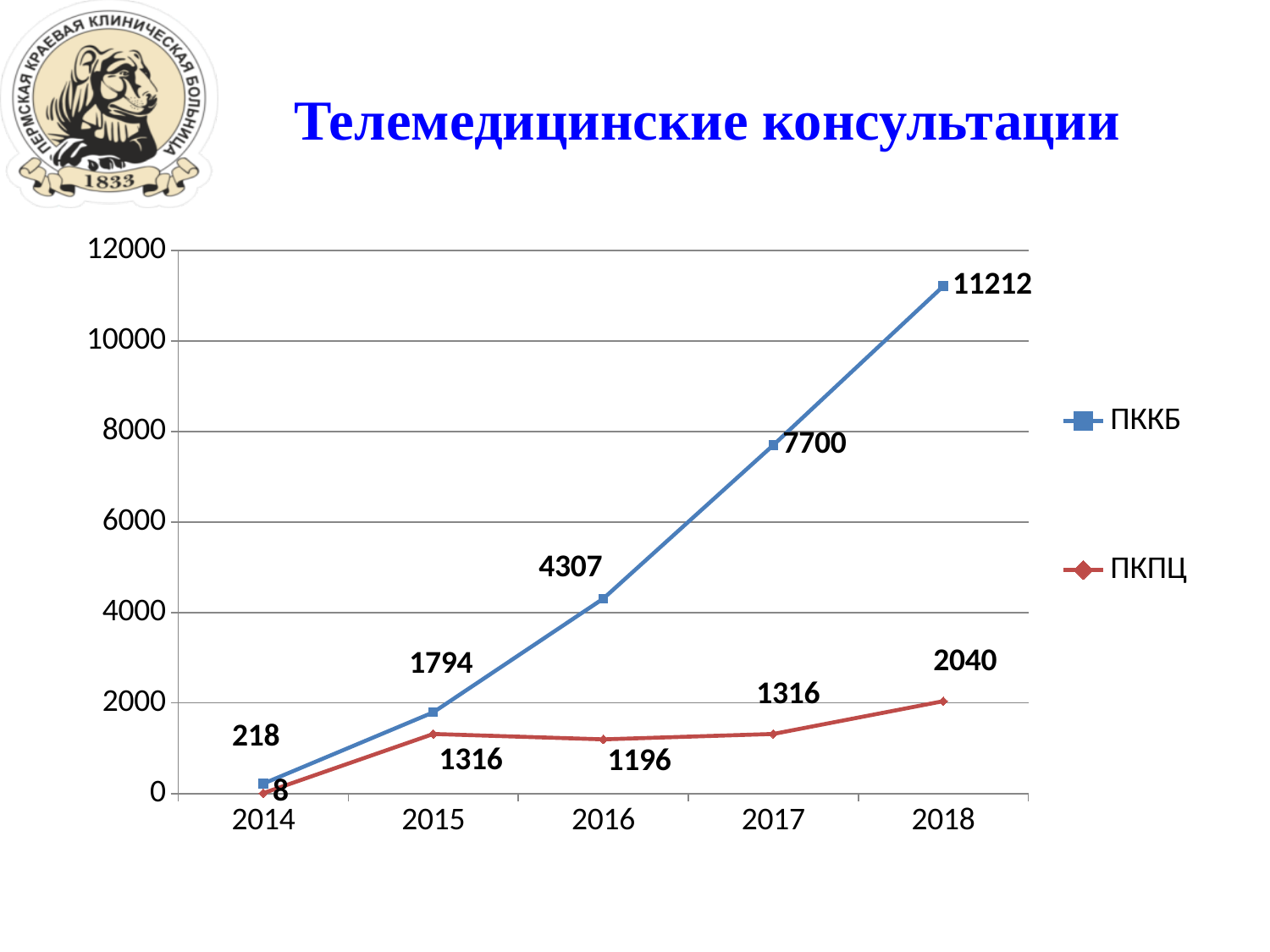
How many series does the legend list? 2 What is the value for ПККБ in 2018? 11212 Does the ПККБ series rise or fall from 2014 to 2018? rise What is the value for ПККБ in 2016? 4307 What type of chart is shown on the slide? line chart What is the difference between the ПККБ values in 2018 and 2017? 3512 Which series has the larger value in 2017, ПККБ or ПКПЦ? ПККБ What is the value for ПКПЦ in 2016? 1196 What is the value for ПКПЦ in 2018? 2040 In which year is the ПКПЦ value lowest? 2014 How many years are shown on the x axis? 5 In which year is the ПККБ value highest? 2018